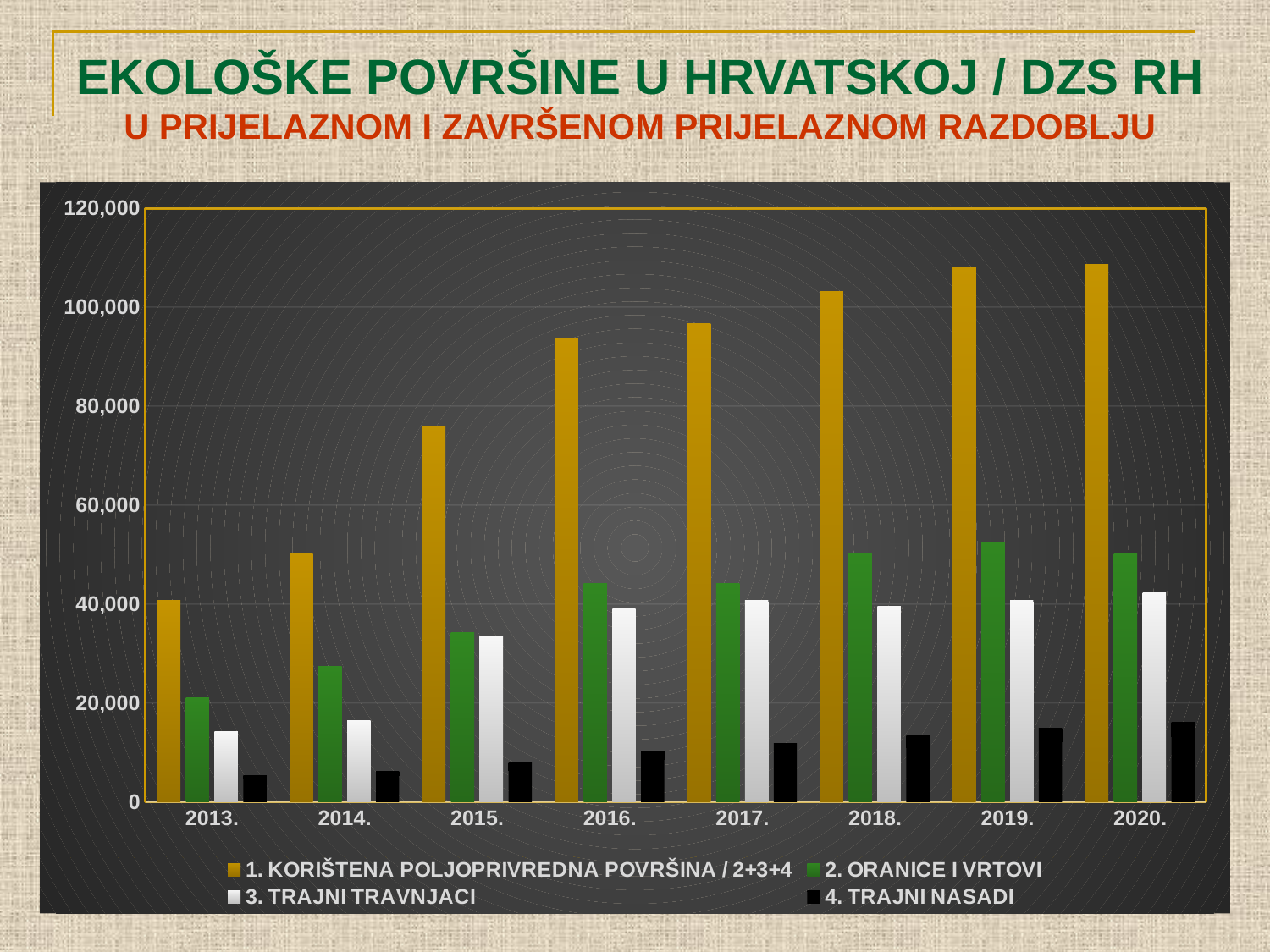
How many series does the chart's legend list? 4 Is the value for 2. ORANICE I VRTOVI in 2018. greater or less than 40,000? greater Does the value for 1. KORIŠTENA POLJOPRIVREDNA POVRŠINA / 2+3+4 generally rise or fall from 2013. to 2020.? rise Is the value for 1. KORIŠTENA POLJOPRIVREDNA POVRŠINA / 2+3+4 in 2016. greater or less than 80,000? greater How many years are shown on the x axis of the chart? 8 Is the value for 4. TRAJNI NASADI in 2020. greater or less than 20,000? less Which year has the lowest value for 3. TRAJNI TRAVNJACI? 2013. What kind of chart is shown on the slide? bar chart In 2016., which is larger: 2. ORANICE I VRTOVI or 3. TRAJNI TRAVNJACI? 2. ORANICE I VRTOVI Which year has the lowest value for 1. KORIŠTENA POLJOPRIVREDNA POVRŠINA / 2+3+4? 2013. Which series is shown in black in the chart? 4. TRAJNI NASADI